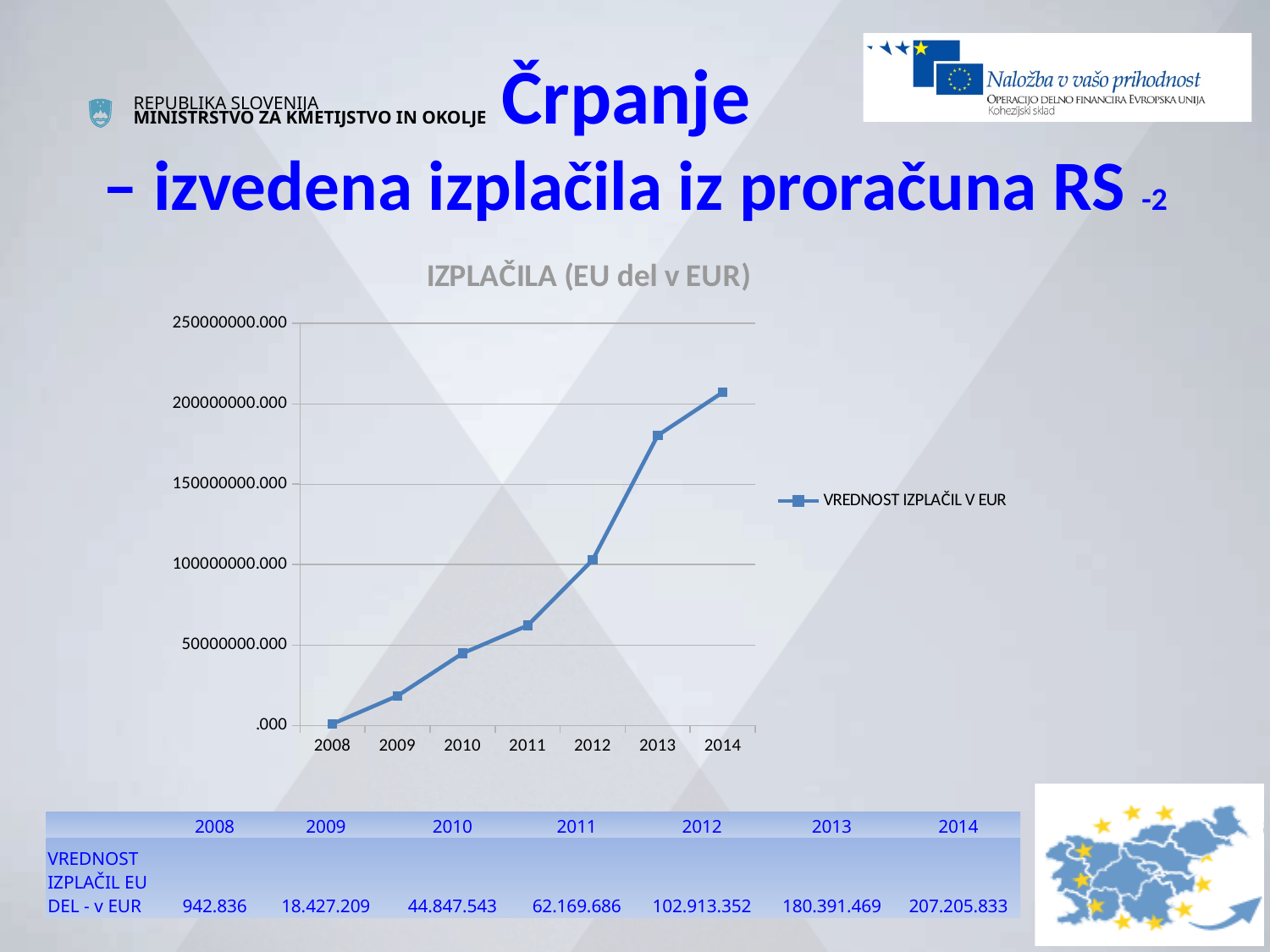
Do the values rise or fall from 2008 to 2014? rise What kind of chart is shown on the slide? line chart What is the value of VREDNOST IZPLAČIL EU DEL for 2008? 942.836 What is the title of the chart? IZPLAČILA (EU del v EUR) Which year has the highest value of VREDNOST IZPLAČIL EU DEL? 2014 How many series does the chart legend list? 1 Which year has the larger value, 2011 or 2013? 2013 How many years are plotted on the x axis of the chart? 7 What is the value of VREDNOST IZPLAČIL EU DEL for 2012? 102.913.352 Which year has the lowest value of VREDNOST IZPLAČIL EU DEL? 2008 Is the value for 2010 greater or less than 50000000.000? less What is the difference between the values for 2014 and 2013? 26.814.364